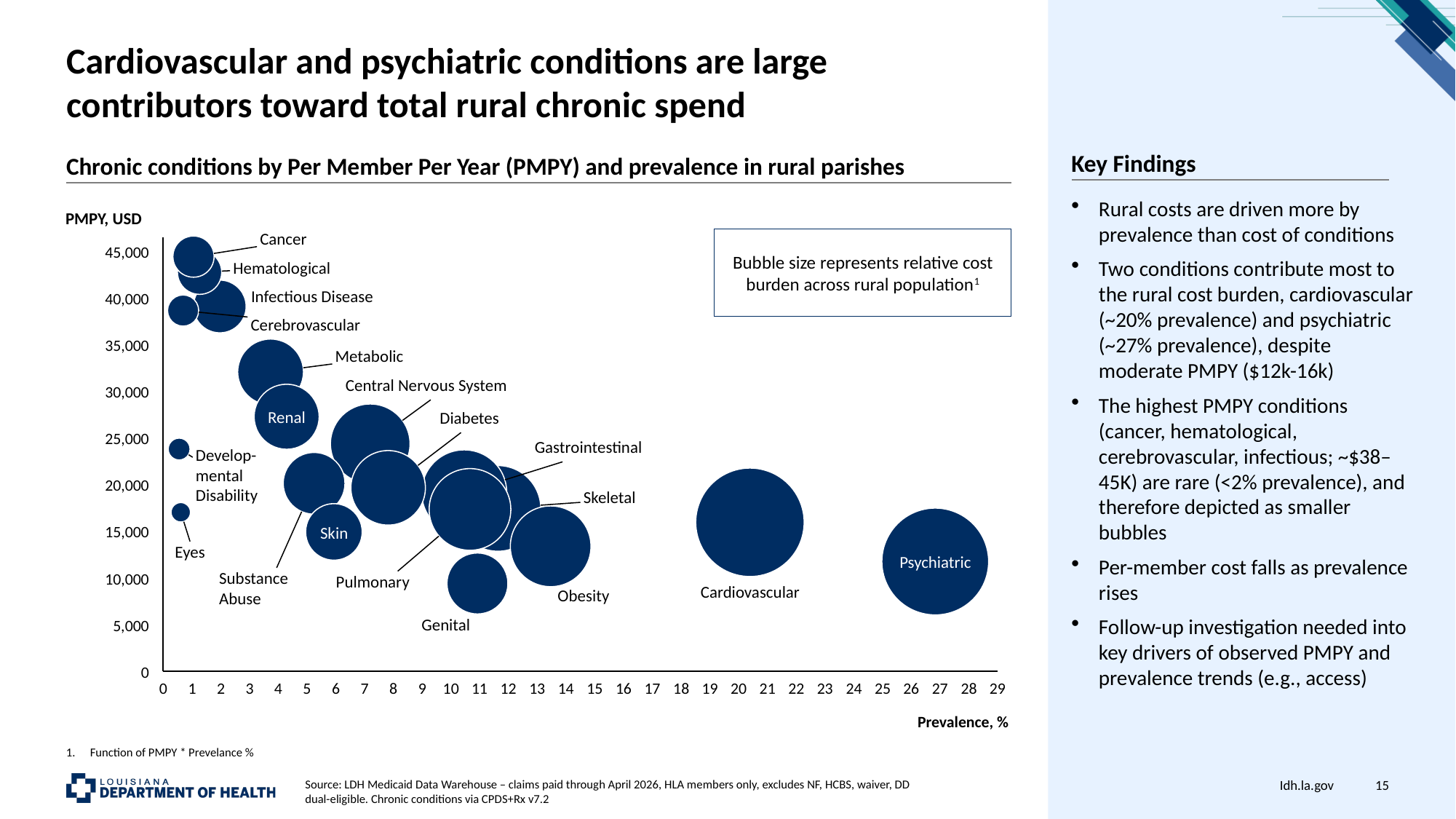
Which condition has the highest prevalence on the chart? Psychiatric Is the prevalence for Obesity greater or less than 10%? greater Is the prevalence for Psychiatric greater or less than 25%? greater Is the PMPY for Metabolic greater or less than 30,000? greater Which condition has the highest PMPY on the chart? Cancer How many chronic conditions are plotted on the chart? 19 Which has the higher prevalence, Cardiovascular or Psychiatric? Psychiatric Which has the higher PMPY, Renal or Skin? Renal According to the chart's note, what does bubble size represent? Relative cost burden across rural population What kind of chart is shown on the slide? Bubble chart Which condition has the lowest PMPY on the chart? Genital